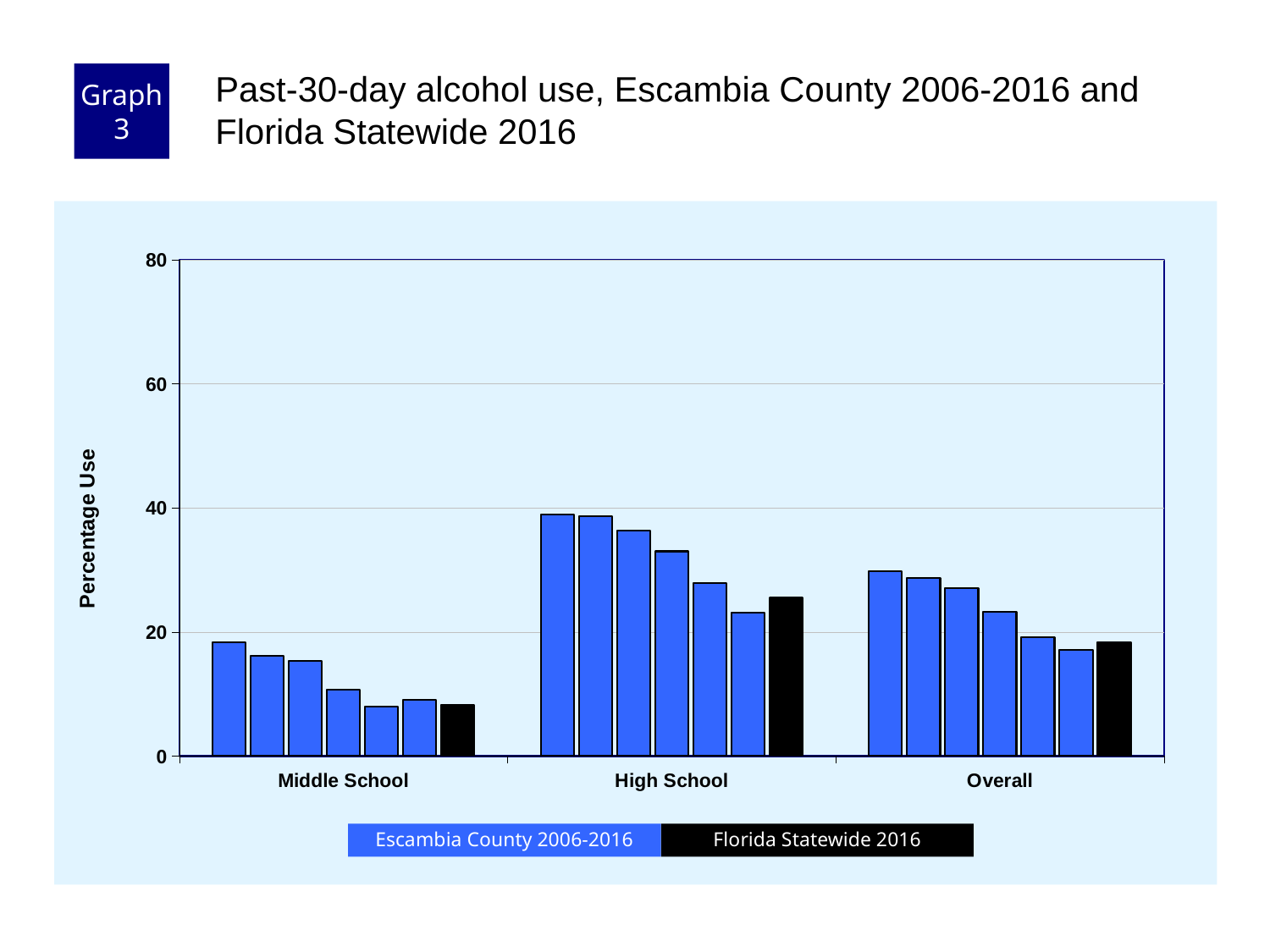
Which category has the lowest percentage use values? Middle School Which is larger, the Florida Statewide 2016 value for High School or for Middle School? High School Within the High School group, do the Escambia County 2006-2016 bars rise or fall from left to right? fall Is the tallest Escambia County bar for High School greater or less than 20? greater Which category has the highest percentage use values? High School What kind of chart is shown on the slide? bar chart What is the label on the y axis? Percentage Use How many school-level categories are shown on the x axis? 3 Is the tallest Escambia County bar for Overall greater or less than 40? less Is the Florida Statewide 2016 value for High School greater or less than 20? greater How many series does the legend list? 2